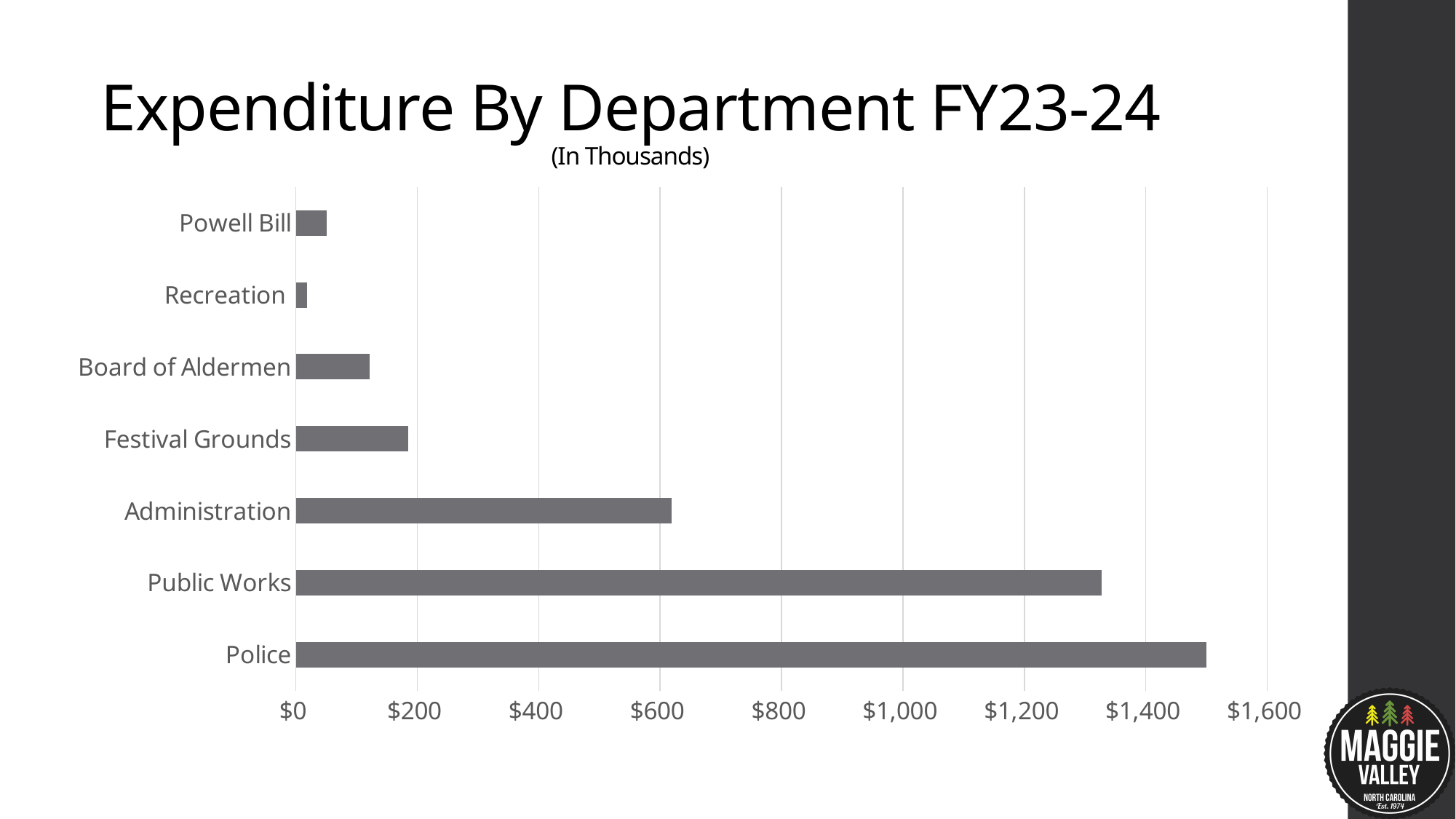
Is the value for Public Works greater or less than $1,400? less How many departments are shown in the chart? 7 Which is larger, the expenditure for Powell Bill or for Festival Grounds? Festival Grounds What is the title of the chart? Expenditure By Department FY23-24 Which department has the lowest expenditure? Recreation What kind of chart is shown on the slide? bar chart Is the value for Board of Aldermen greater or less than $200? less Is the value for Police greater or less than $1,400? greater Which department has the highest expenditure? Police Which is larger, the expenditure for Administration or for Public Works? Public Works